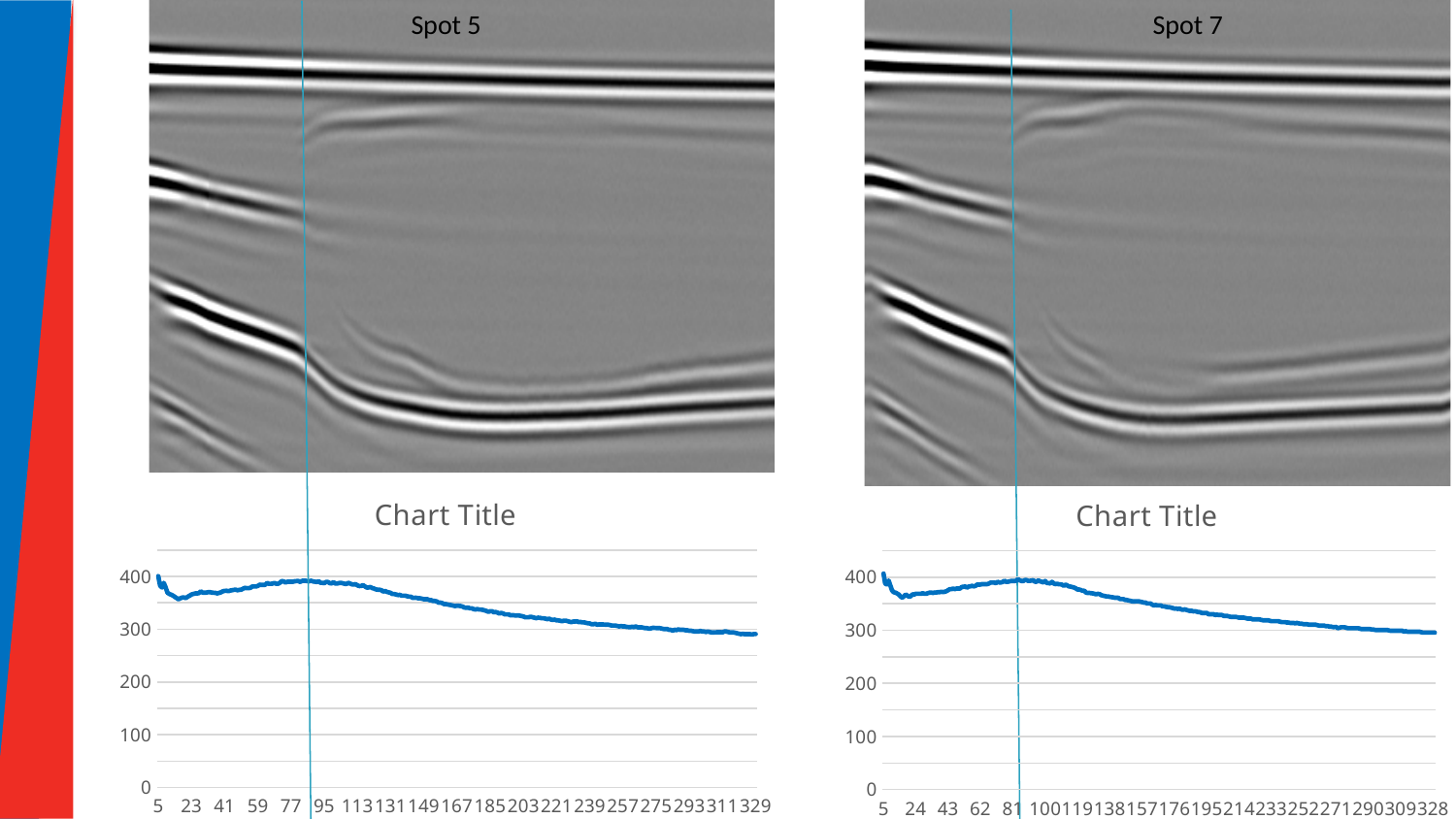
In the left chart, is the value at x = 5 greater or less than 300? greater How many lines are plotted in the right chart? 1 What is the highest value labelled on the y axis of the right chart? 400 In the left chart, is the value at x = 329 greater or less than 400? less What kind of chart is the left chart below the Spot 5 image? line chart In the right chart, is the value at x = 328 greater or less than 400? less What is the title of the left chart? Chart Title What kind of chart is the right chart below the Spot 7 image? line chart In the left chart, do the values overall rise or fall from x = 113 to x = 329? fall In the right chart, do the values overall rise or fall from x = 100 to x = 328? fall